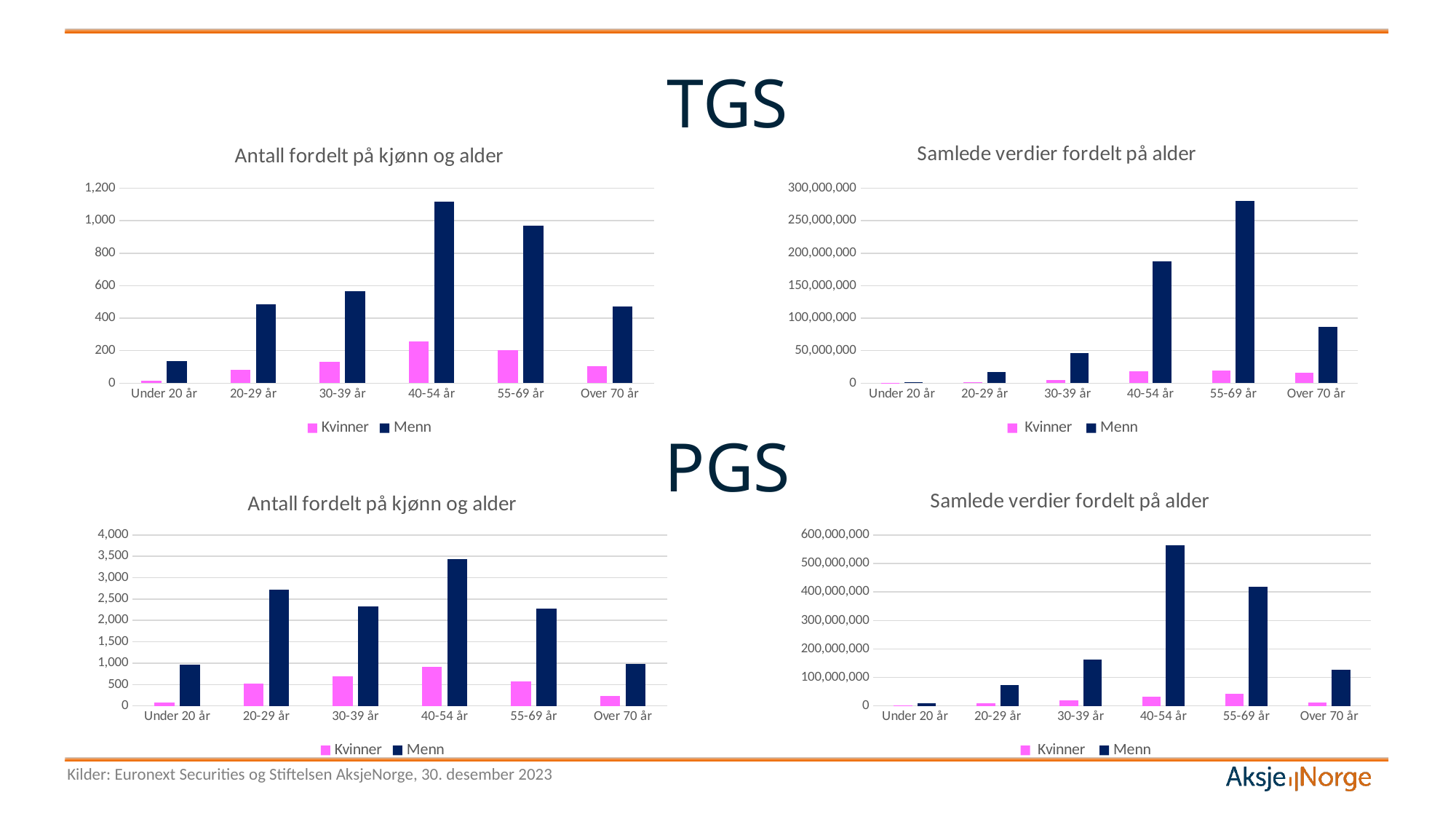
In the PGS 'Antall fordelt på kjønn og alder' chart (bottom left), which age group has the highest value for Menn? 40-54 år In the TGS 'Antall fordelt på kjønn og alder' chart (top left), is the value for Menn in the 40-54 år group greater or less than 1,000? greater In the TGS 'Samlede verdier fordelt på alder' chart (top right), which age group has the highest value for Menn? 55-69 år How many age groups are shown on the x axis of the TGS 'Antall fordelt på kjønn og alder' chart (top left)? 6 In the PGS 'Antall fordelt på kjønn og alder' chart (bottom left), is the value for Menn in the 40-54 år group greater or less than 3,000? greater How many series does the legend of the PGS 'Samlede verdier fordelt på alder' chart (bottom right) list? 2 In the PGS 'Samlede verdier fordelt på alder' chart (bottom right), is the value for Menn in the 40-54 år group greater or less than 500,000,000? greater In the TGS 'Antall fordelt på kjønn og alder' chart (top left), which age group has the lowest value for Kvinner? Under 20 år In the TGS 'Antall fordelt på kjønn og alder' chart (top left), which age group has the highest value for Menn? 40-54 år In the PGS 'Antall fordelt på kjønn og alder' chart (bottom left), which is larger for Menn: 20-29 år or 30-39 år? 20-29 år